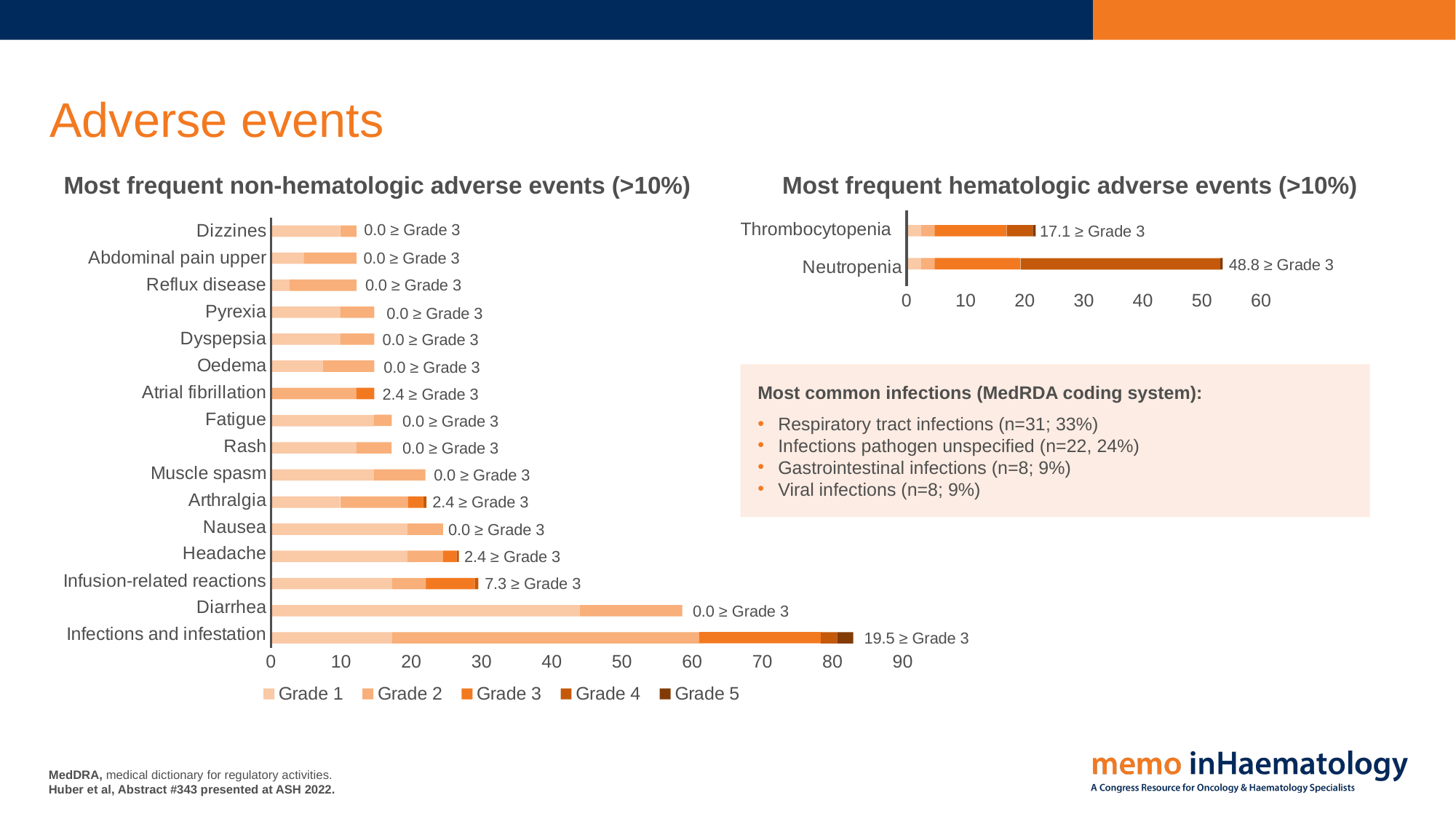
On the 'Most frequent non-hematologic adverse events (>10%)' chart, is the total bar for Diarrhea greater or less than 50? greater On the 'Most frequent non-hematologic adverse events (>10%)' chart, which adverse event has the longest total bar? Infections and infestation On the 'Most frequent non-hematologic adverse events (>10%)' chart, what is the ≥ Grade 3 value labelled for Infusion-related reactions? 7.3 On the 'Most frequent hematologic adverse events (>10%)' chart, how many adverse event categories are plotted? 2 On the 'Most frequent hematologic adverse events (>10%)' chart, what is the ≥ Grade 3 value labelled for Thrombocytopenia? 17.1 On the 'Most frequent non-hematologic adverse events (>10%)' chart, what is the ≥ Grade 3 value labelled for Infections and infestation? 19.5 On the 'Most frequent hematologic adverse events (>10%)' chart, what is the ≥ Grade 3 value labelled for Neutropenia? 48.8 On the 'Most frequent non-hematologic adverse events (>10%)' chart, how many adverse event categories are plotted? 16 On the 'Most frequent non-hematologic adverse events (>10%)' chart, what kind of chart is shown? Stacked bar chart On the 'Most frequent non-hematologic adverse events (>10%)' chart, how many series does the legend list? 5 On the 'Most frequent hematologic adverse events (>10%)' chart, what is the difference between the ≥ Grade 3 values for Neutropenia and Thrombocytopenia? 31.7 On the 'Most frequent non-hematologic adverse events (>10%)' chart, which has a longer total bar, Headache or Dizzines? Headache